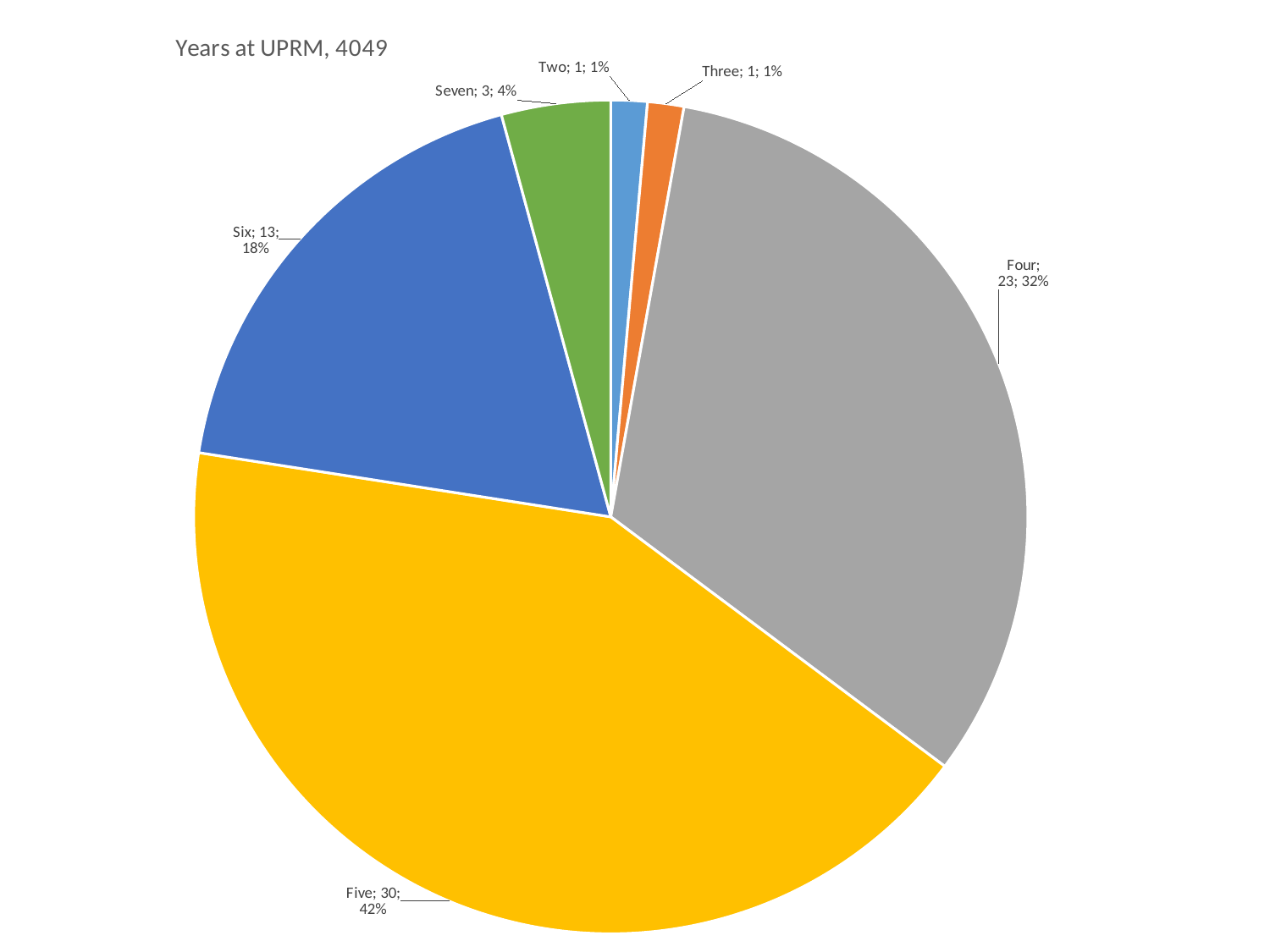
What is the value for the Seven slice? 3 What is the difference between the values for Five and Four? 7 How many slices does the pie chart have? 6 What kind of chart is shown on the slide? pie chart What share of the pie does the Six slice represent? 18% What is the value for the Four slice? 23 What share of the pie does the Four slice represent? 32% Which category has the largest slice? Five Which is larger, the value for Six or the value for Seven? Six What is the value for the Five slice? 30 What is the value for the Six slice? 13 What is the title of the chart? Years at UPRM, 4049